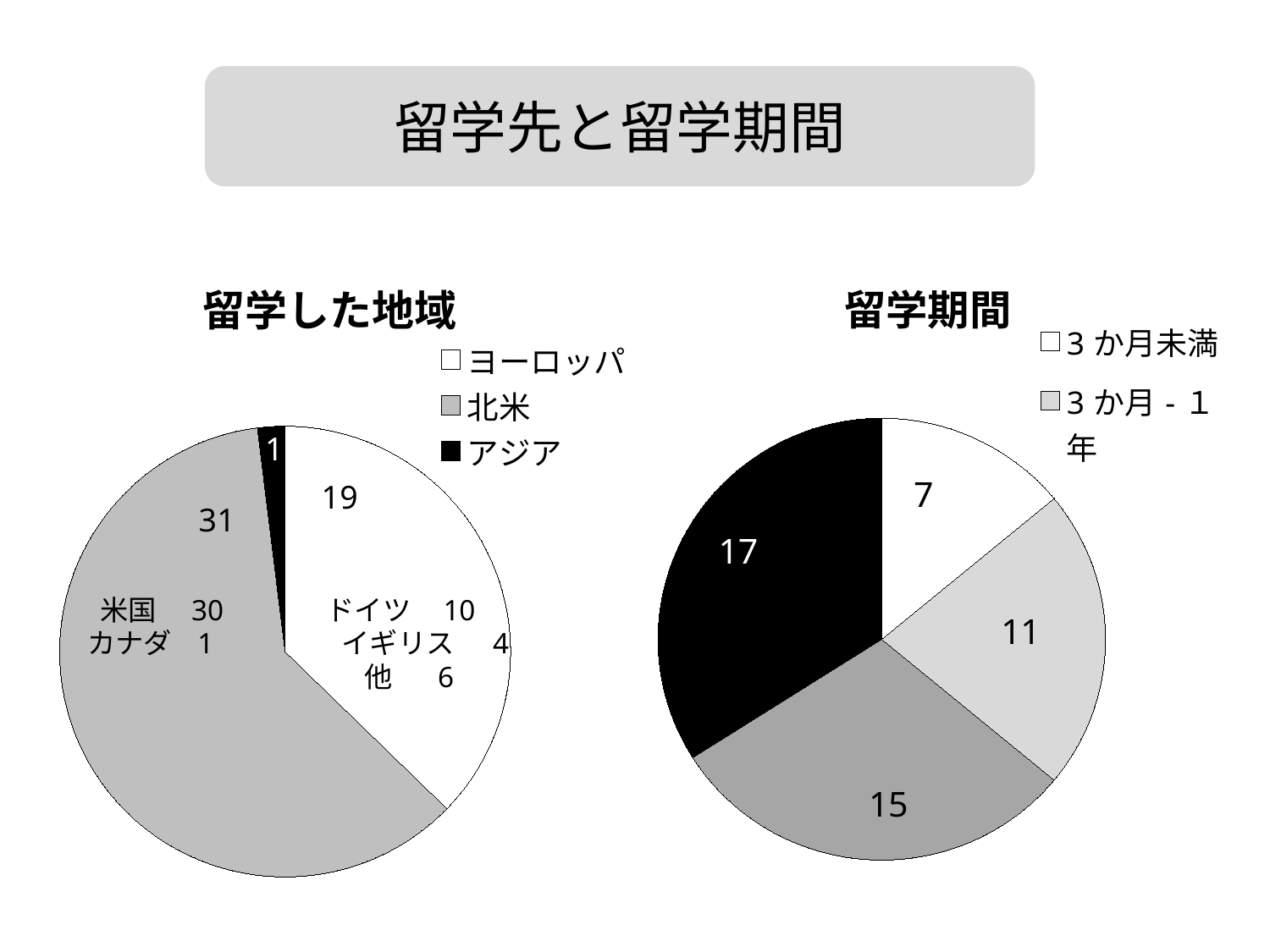
In the 留学した地域 chart, which region has the largest value? 北米 In the 留学した地域 chart, what is the value for 北米? 31 In the 留学期間 chart, what is the value for 3か月-1年? 11 What type of chart is the 留学した地域 chart? pie chart How many entries does the legend of the 留学した地域 chart list? 3 In the 留学期間 chart, what is the value for 3か月未満? 7 In the 留学期間 chart, which is larger, 3か月未満 or 3か月-1年? 3か月-1年 In the 留学した地域 chart, what is the value for アジア? 1 In the 留学した地域 chart, which region has the smallest value? アジア How many slices does the 留学期間 pie chart have? 4 In the 留学した地域 chart, what is the value for ヨーロッパ? 19 In the 留学した地域 chart, what is the difference between 北米 and ヨーロッパ? 12